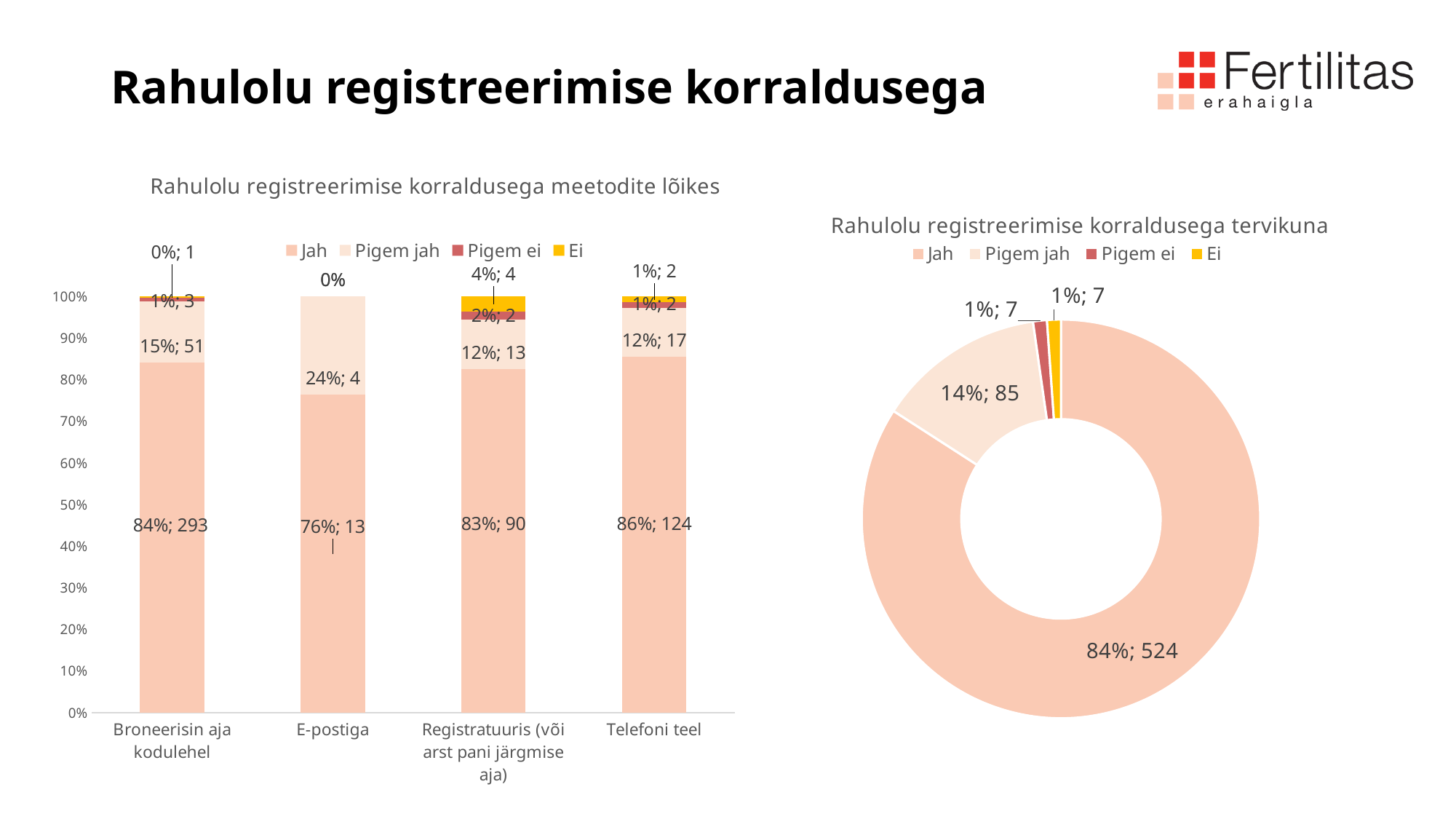
In the chart 'Rahulolu registreerimise korraldusega tervikuna', what is the difference in count between 'Jah' (524) and 'Pigem jah' (85)? 439 In the chart 'Rahulolu registreerimise korraldusega meetodite lõikes', how many categories are shown on the x axis? 4 In the chart 'Rahulolu registreerimise korraldusega meetodite lõikes', what is the data label for 'Ei' in the 'Registratuuris (või arst pani järgmise aja)' bar? 4%; 4 In the chart 'Rahulolu registreerimise korraldusega meetodite lõikes', what is the data label for 'Jah' in the 'Telefoni teel' bar? 86%; 124 In the chart 'Rahulolu registreerimise korraldusega meetodite lõikes', how many series does the legend list? 4 In the chart 'Rahulolu registreerimise korraldusega tervikuna', what share of the pie does 'Pigem jah' take? 14% What kind of chart is 'Rahulolu registreerimise korraldusega tervikuna'? Doughnut chart In the chart 'Rahulolu registreerimise korraldusega meetodite lõikes', which category has the highest 'Jah' percentage? Telefoni teel What kind of chart is 'Rahulolu registreerimise korraldusega meetodite lõikes'? Stacked bar chart In the chart 'Rahulolu registreerimise korraldusega tervikuna', what is the data label for the 'Jah' slice? 84%; 524 In the chart 'Rahulolu registreerimise korraldusega meetodite lõikes', which category has the lowest 'Jah' percentage? E-postiga In the chart 'Rahulolu registreerimise korraldusega meetodite lõikes', what is the data label for 'Pigem jah' in the 'Broneerisin aja kodulehel' bar? 15%; 51